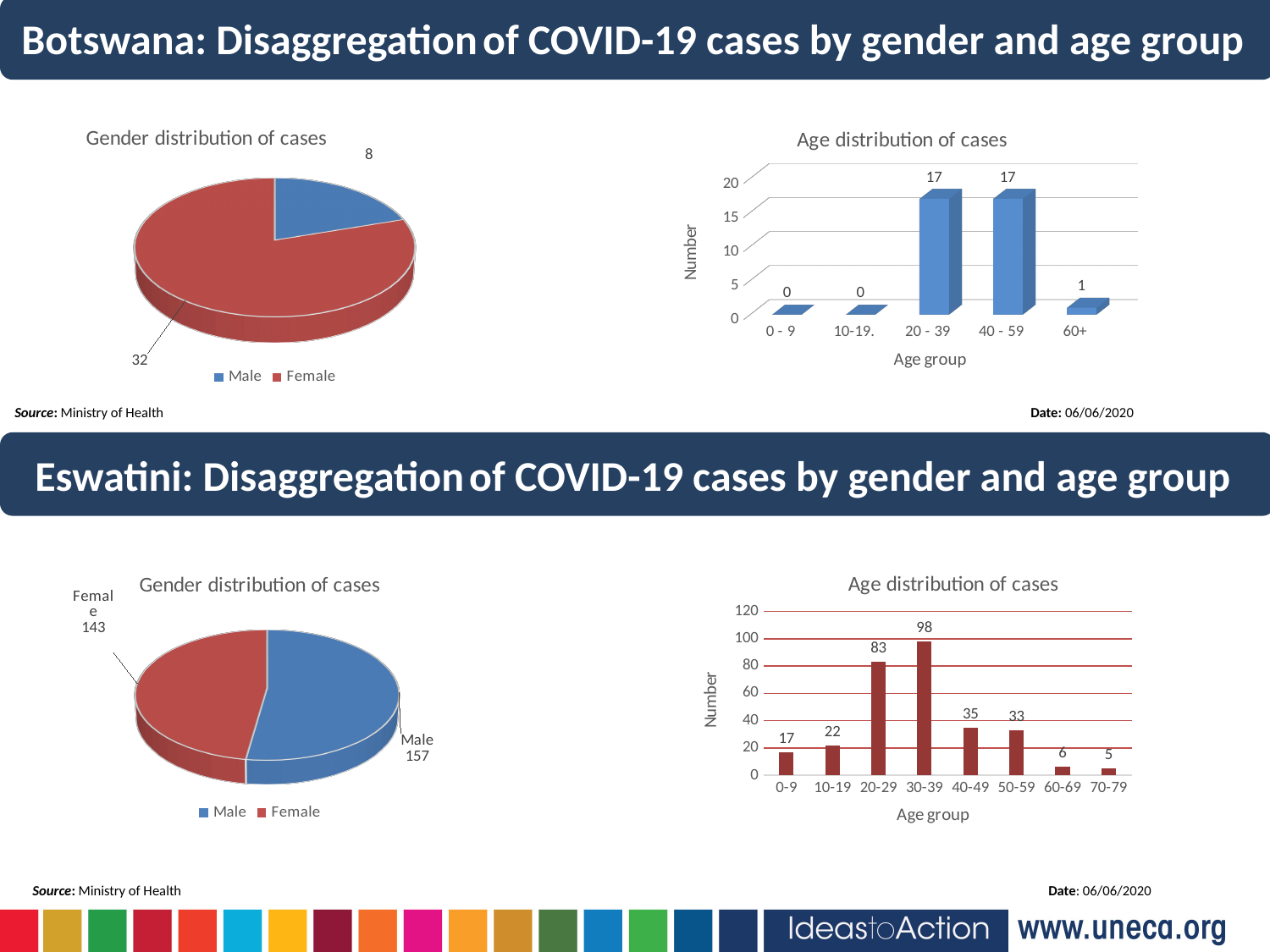
In the Eswatini age distribution chart, which is larger, the value for 40-49 or the value for 50-59? 40-49 In the Botswana age distribution chart, what is the value for the 60+ age group? 1 In the Botswana age distribution chart, how many age groups are shown on the x axis? 5 In the Eswatini gender distribution pie chart, what is the difference between male and female cases? 14 In the Botswana gender distribution pie chart, how many cases are female? 32 What kind of chart is the Eswatini age distribution of cases chart? Bar chart In the Botswana age distribution chart, what is the difference between the 20 - 39 group and the 60+ group? 16 In the Eswatini age distribution chart, which age group has the highest number of cases? 30-39 In the Eswatini age distribution chart, which age group has the lowest number of cases? 70-79 In the Botswana gender distribution pie chart, what share of cases are male? 20% In the Eswatini gender distribution pie chart, how many cases are male? 157 In the Eswatini age distribution chart, what is the value for the 20-29 age group? 83